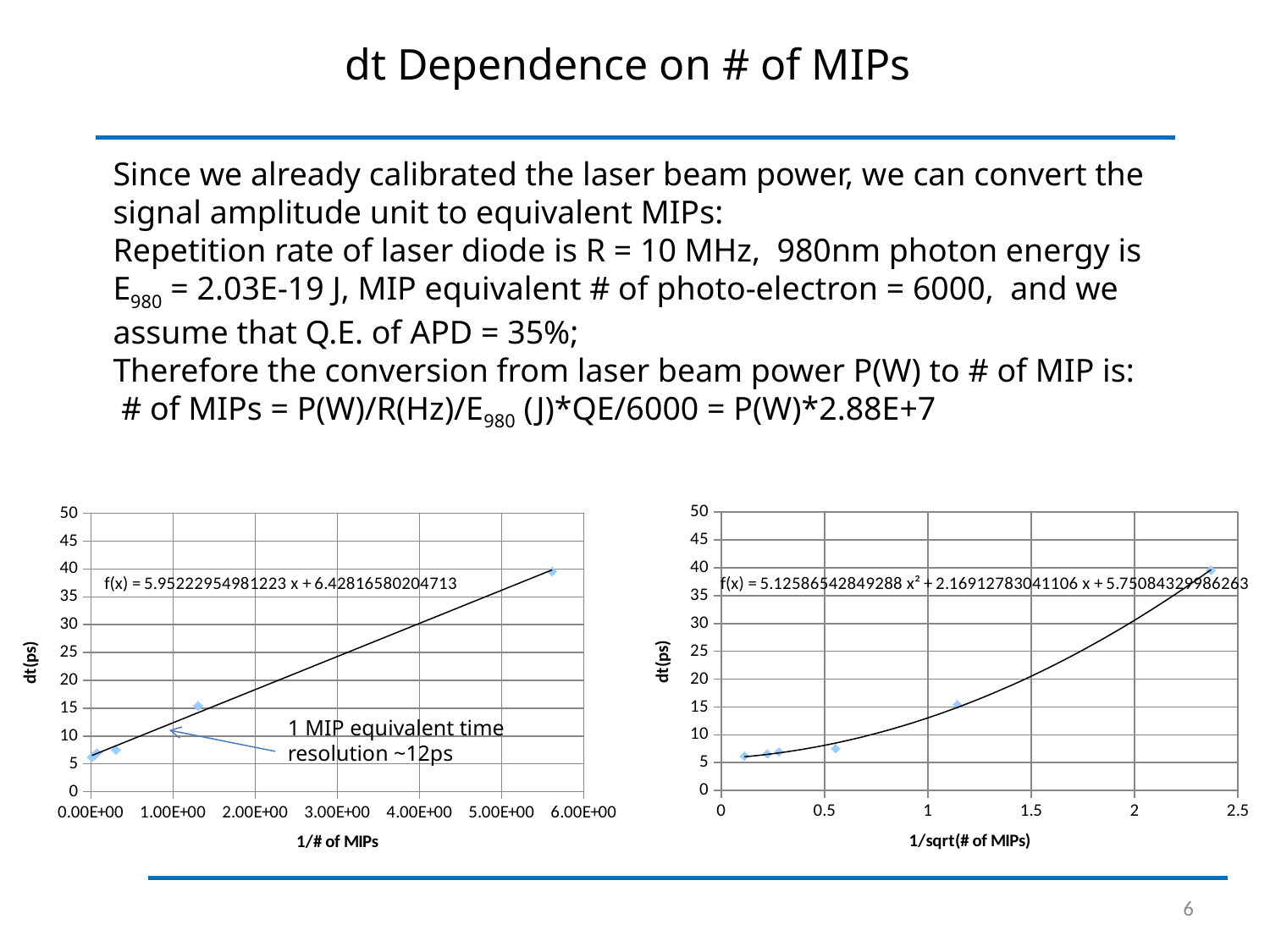
In the right chart (1/sqrt(# of MIPs)), is the dt(ps) value of the point near x = 1.15 greater or less than 20? less What is the x-axis label of the right chart? 1/sqrt(# of MIPs) In the left chart (1/# of MIPs), is the dt(ps) value of the rightmost point greater or less than 35? greater What kind of chart is the right chart with x axis '1/sqrt(# of MIPs)'? scatter chart What is the y-axis label of the left chart? dt(ps) In the left chart (1/# of MIPs), is the dt(ps) value of the leftmost point greater or less than 10? less In the right chart (1/sqrt(# of MIPs)), do the dt(ps) values rise or fall as 1/sqrt(# of MIPs) increases? rise What kind of chart is the left chart with x axis '1/# of MIPs'? scatter chart In the left chart (1/# of MIPs), do the dt(ps) values rise or fall as 1/# of MIPs increases? rise